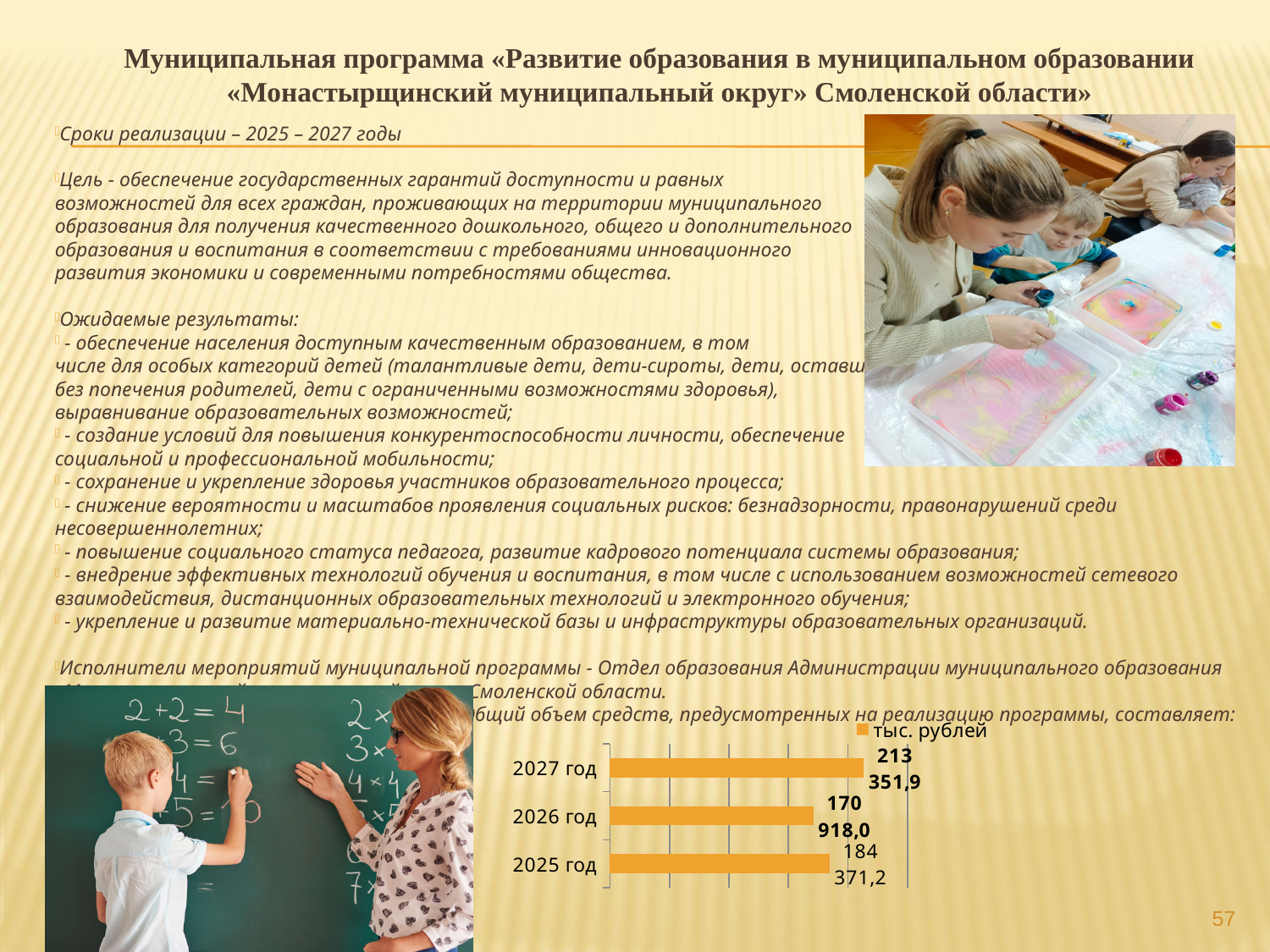
What is the difference between the values for 2027 год and 2025 год? 28 980,7 What kind of chart is shown on the slide? Bar chart Which is larger, the value for 2025 год or the value for 2026 год? 2025 год Which year has the highest value on the chart? 2027 год What is the value for 2025 год on the chart? 184 371,2 What is the value for 2026 год on the chart? 170 918,0 What is the legend entry of the chart? тыс. рублей What is the difference between the values for 2025 год and 2026 год? 13 453,2 How many series does the chart legend list? 1 How many categories (years) are shown on the chart? 3 What is the value for 2027 год on the chart? 213 351,9 Which year has the lowest value on the chart? 2026 год